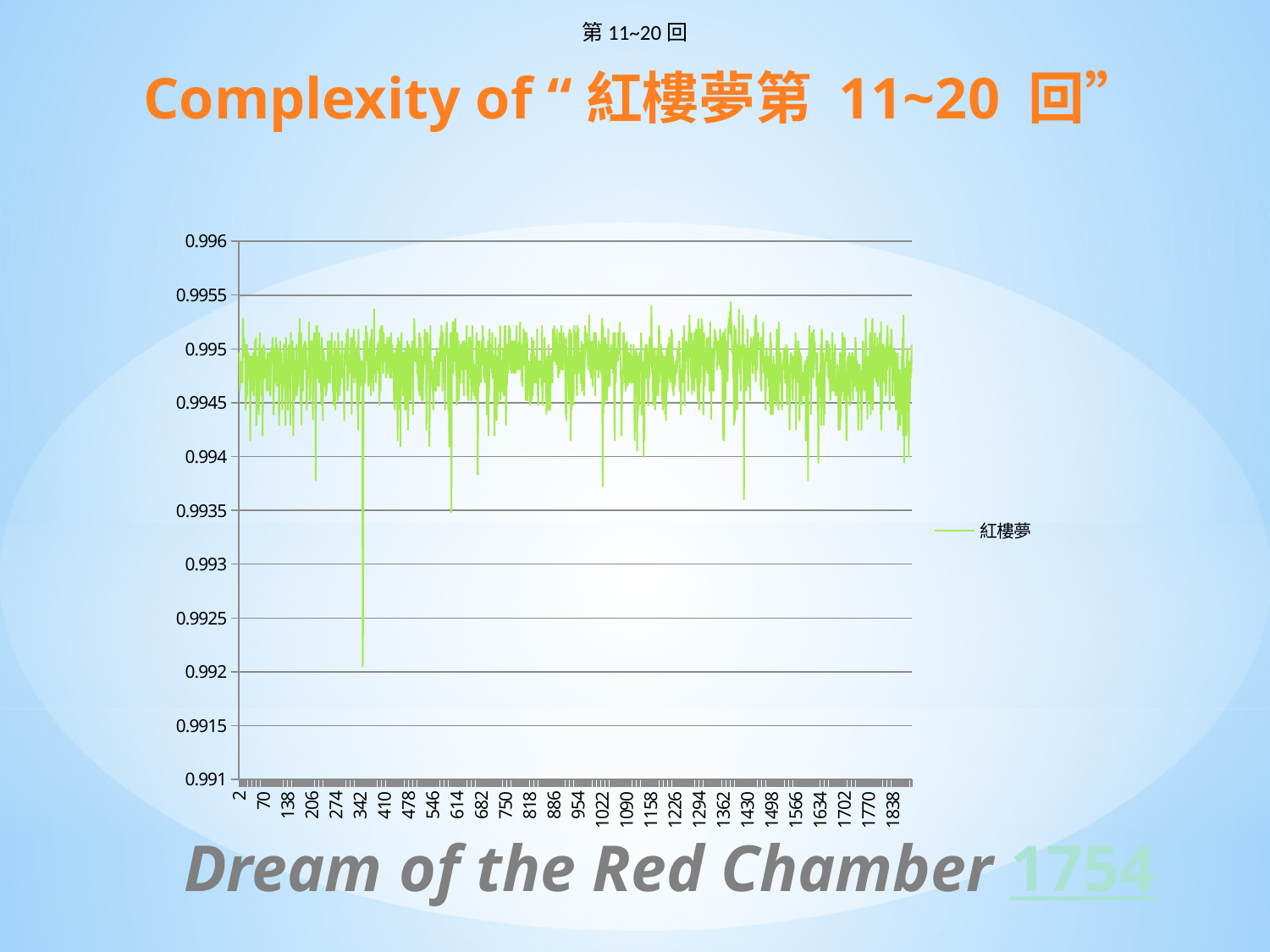
What is the first label on the chart's horizontal axis? 2 How many series does the chart legend list? 1 Are most of the plotted values greater or less than 0.994? greater What is the lowest value labelled on the chart's vertical axis? 0.991 Does the line show a clear overall rising or falling trend along the x axis, or does it stay roughly level? roughly level Is the highest point of the line greater or less than 0.996? less What is the name of the series shown in the chart legend? 紅樓夢 What is the highest value labelled on the chart's vertical axis? 0.996 Is the lowest point of the line (the sharp dip near x = 342) greater or less than 0.9925? less What kind of chart is shown on the slide? line chart What is the last label on the chart's horizontal axis? 1838